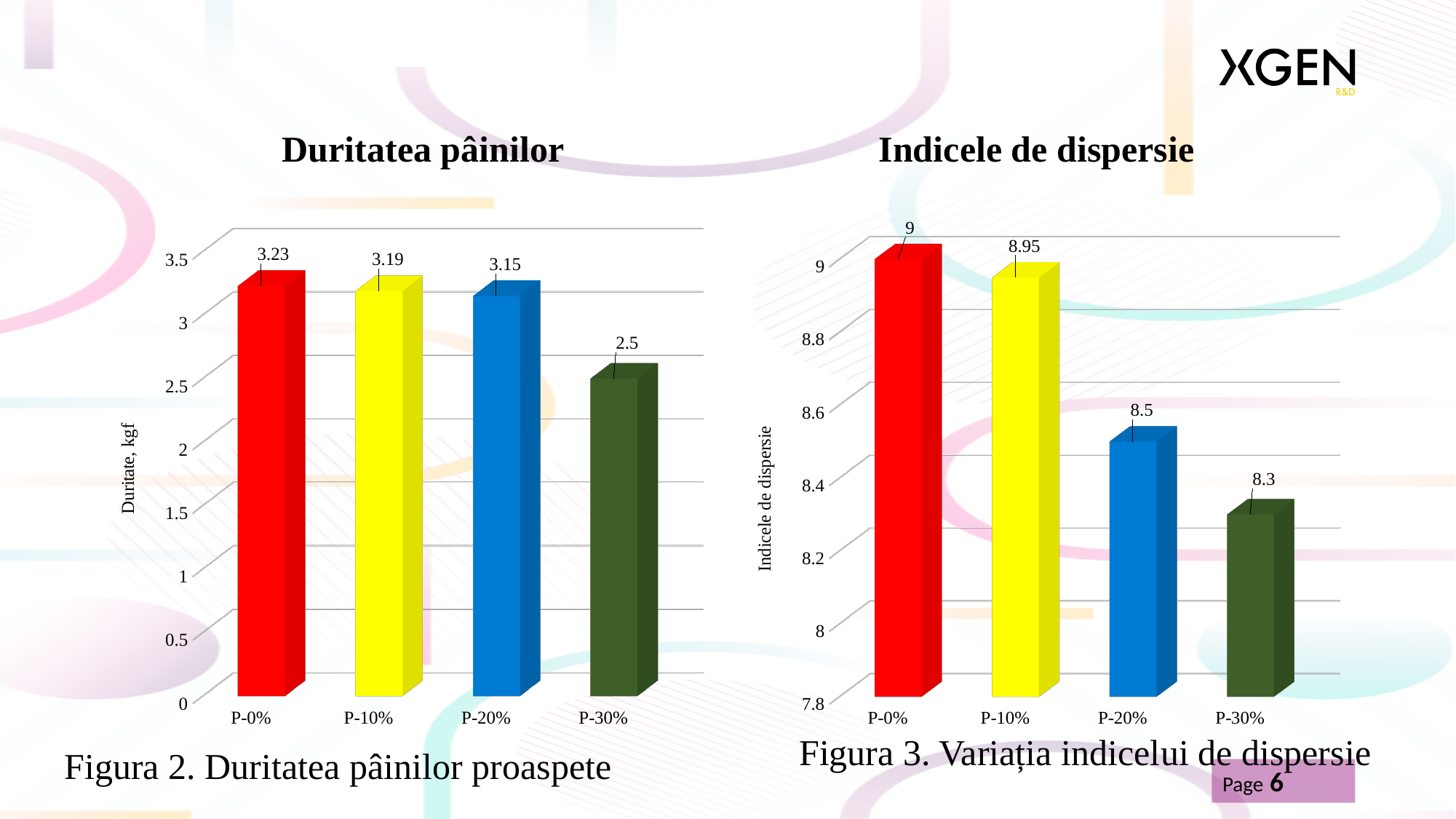
In the 'Duritatea pâinilor' chart, what is the value for P-0%? 3.23 In the 'Indicele de dispersie' chart, what is the difference between the values for P-20% and P-30%? 0.2 In the 'Duritatea pâinilor' chart, which category has the lowest value? P-30% In the 'Duritatea pâinilor' chart, what is the value for P-30%? 2.5 What kind of chart is the 'Indicele de dispersie' chart? bar chart In the 'Indicele de dispersie' chart, what is the value for P-20%? 8.5 In the 'Duritatea pâinilor' chart, how many categories are shown on the x axis? 4 In the 'Indicele de dispersie' chart, which category has the highest value? P-0% In the 'Indicele de dispersie' chart, do the values rise or fall from P-0% to P-30%? fall In the 'Duritatea pâinilor' chart, what is the difference between the values for P-0% and P-30%? 0.73 In the 'Duritatea pâinilor' chart, what is the y-axis label? Duritate, kgf In the 'Indicele de dispersie' chart, what is the value for P-10%? 8.95